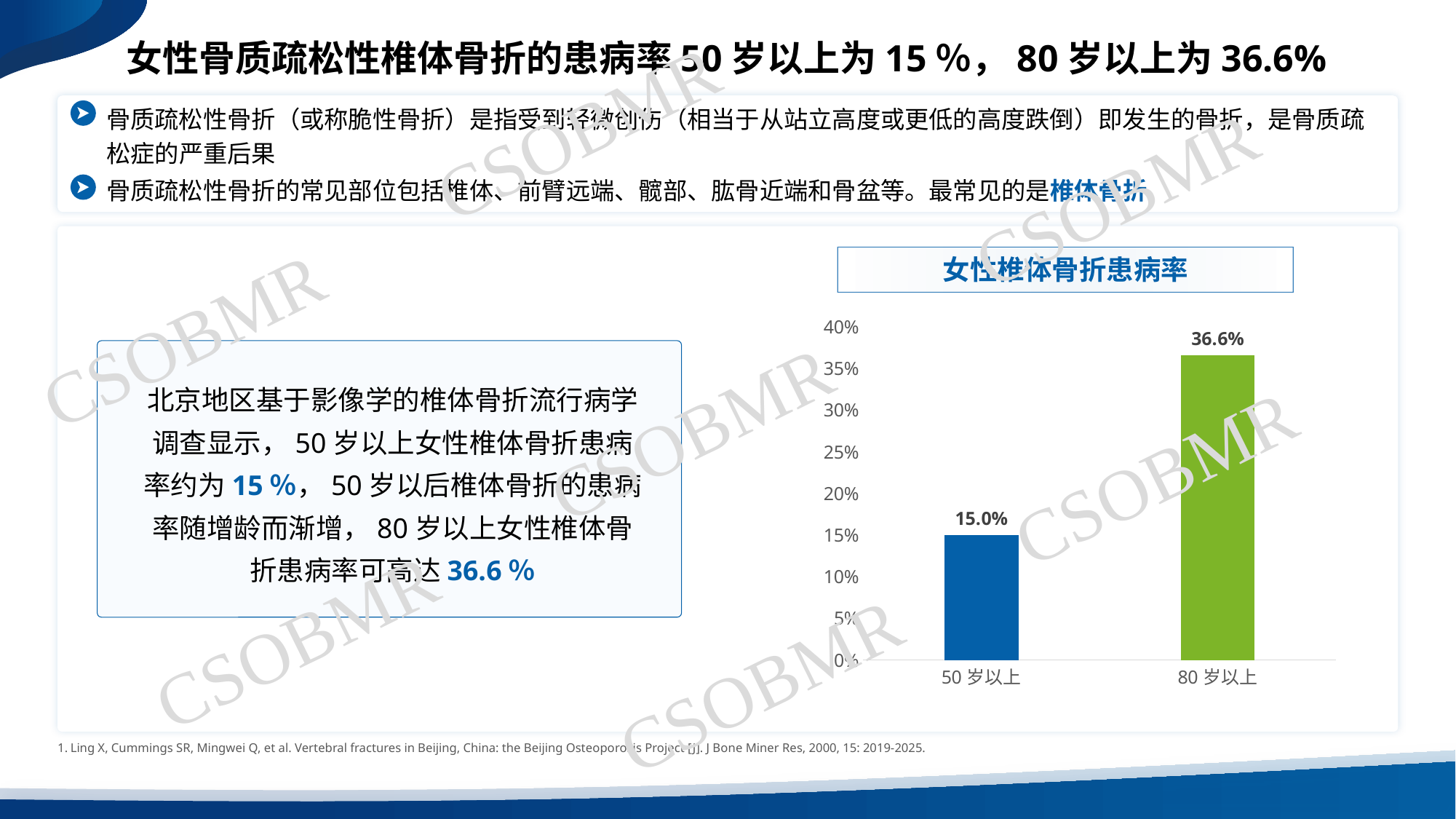
Is the value for 80 岁以上 greater or less than 30%? greater Which age group has the highest prevalence in the chart? 80 岁以上 Which age group has the lowest prevalence in the chart? 50 岁以上 Which is larger, the value for 50 岁以上 or the value for 80 岁以上? 80 岁以上 What kind of chart is shown on the slide? bar chart Do the values rise or fall from 50 岁以上 to 80 岁以上? rise What is the title of the chart? 女性椎体骨折患病率 What is the difference between the values for 80 岁以上 and 50 岁以上? 21.6% How many categories are shown on the x axis of the chart? 2 Is the value for 50 岁以上 greater or less than 20%? less What is the value for 80 岁以上 in the chart? 36.6% What is the value for 50 岁以上 in the chart? 15.0%